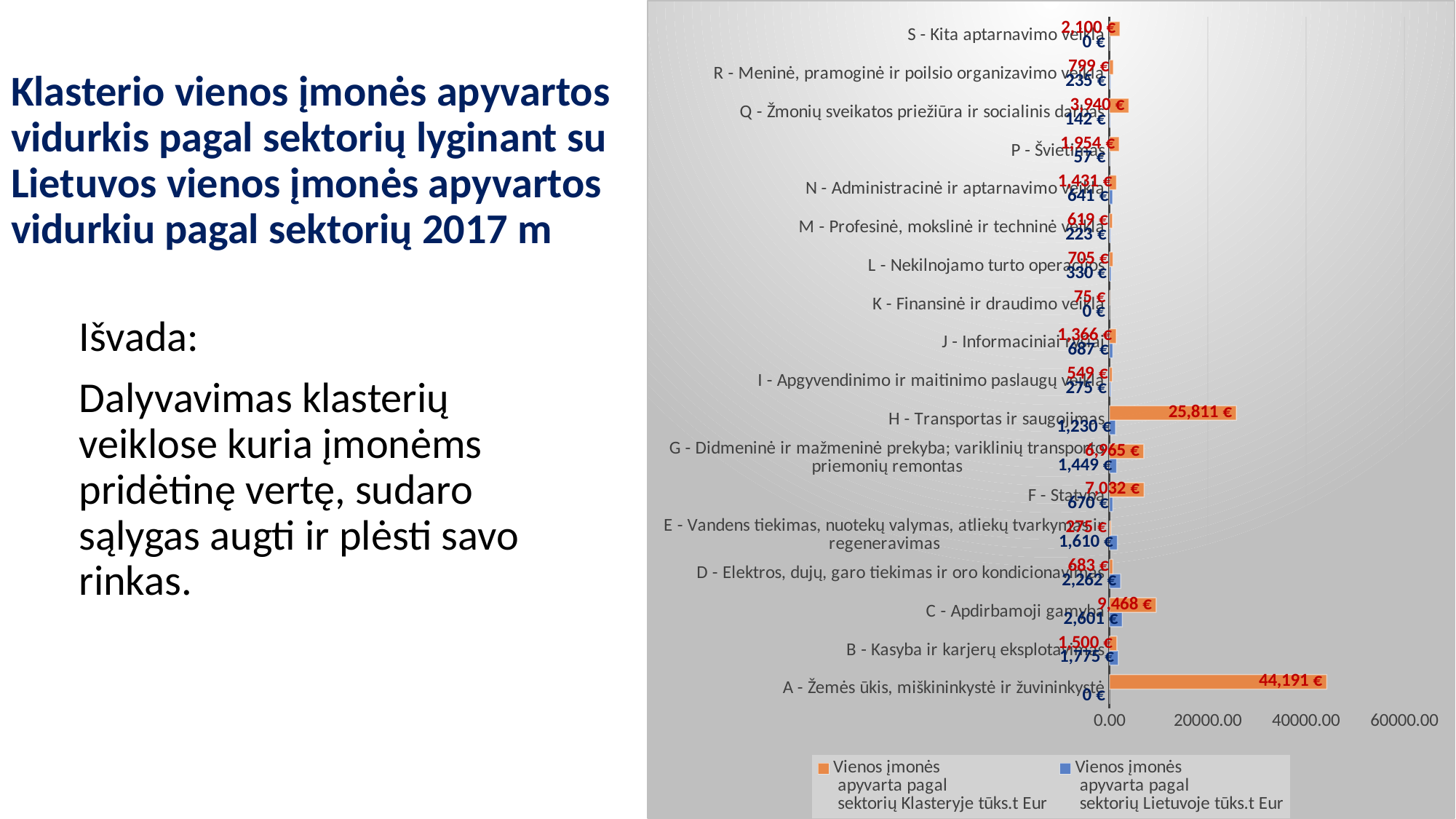
Is the cluster value for sector A - Žemės ūkis, miškininkystė ir žuvininkystė greater or less than 40000? greater What is the Lithuania (Lietuvoje) value for sector B - Kasyba ir karjerų eksploatavimas? 1,775 € Which sector has the highest cluster (Klasteryje) value? A - Žemės ūkis, miškininkystė ir žuvininkystė What is the difference between the cluster value and the Lithuania value for sector H - Transportas ir saugojimas? 24,581 € For sector D - Elektros, dujų, garo tiekimas ir oro kondicionavimas, which is larger: the cluster value or the Lithuania value? Lithuania value (2,262 €) What is the cluster (Klasteryje) value for sector A - Žemės ūkis, miškininkystė ir žuvininkystė? 44,191 € How many series does the chart legend list? 2 What is the Lithuania (Lietuvoje) value for sector C - Apdirbamoji gamyba? 2,601 € What kind of chart is shown on the slide? bar chart How many sector categories are plotted on the chart? 18 What is the cluster (Klasteryje) value for sector H - Transportas ir saugojimas? 25,811 € Which colour represents the series 'Vienos įmonės apyvarta pagal sektorių Klasteryje tūks.t Eur'? orange